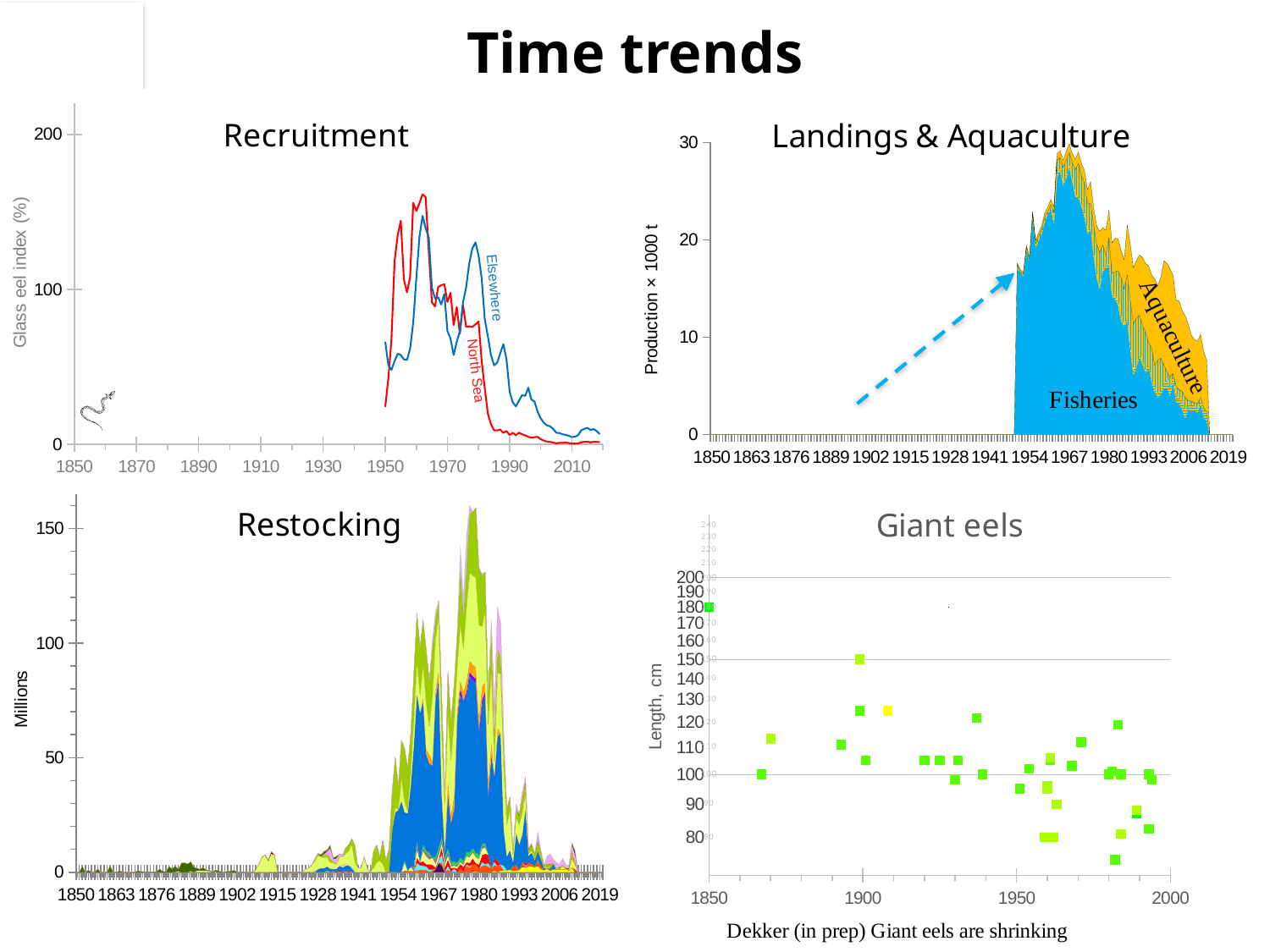
In the Recruitment chart, is the North Sea value around 2010 greater or less than 50? less In the Landings & Aquaculture chart, do the values rise or fall from 1970 to 2010? fall In the Recruitment chart, which two series are labelled? Elsewhere and North Sea What kind of chart is the Recruitment chart? line chart In the Recruitment chart, do the values rise or fall between 1980 and 2010? fall What kind of chart is the Giant eels chart? scatter plot In the Landings & Aquaculture chart, is the peak total production around 1967 greater or less than 20? greater In the Landings & Aquaculture chart, which two components are labelled in the plot area? Fisheries and Aquaculture In the Restocking chart, is the value around 1900 greater or less than 50? less In the Giant eels chart, do the lengths rise or fall from 1850 to 2000? fall